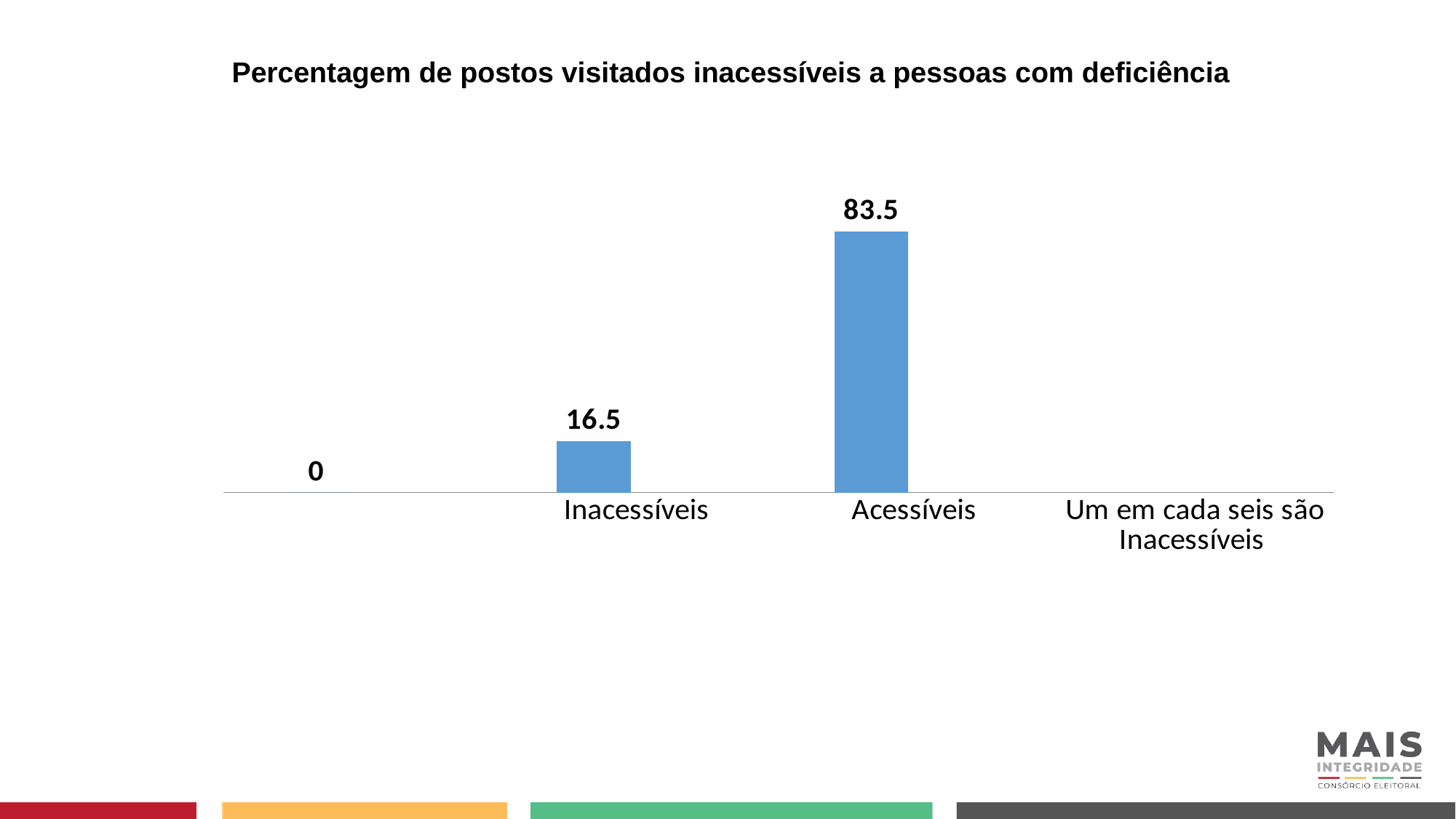
What is the title of the chart? Percentagem de postos visitados inacessíveis a pessoas com deficiência Which category has the highest value? Acessíveis How many bars are visibly plotted in the chart? 2 What colour are the bars in the chart? blue What kind of chart is shown on the slide? bar chart What is the difference between the values for Acessíveis and Inacessíveis? 67 Which is larger, the value for Inacessíveis or the value for Acessíveis? Acessíveis What is the value for Inacessíveis? 16.5 What is the value for Acessíveis? 83.5